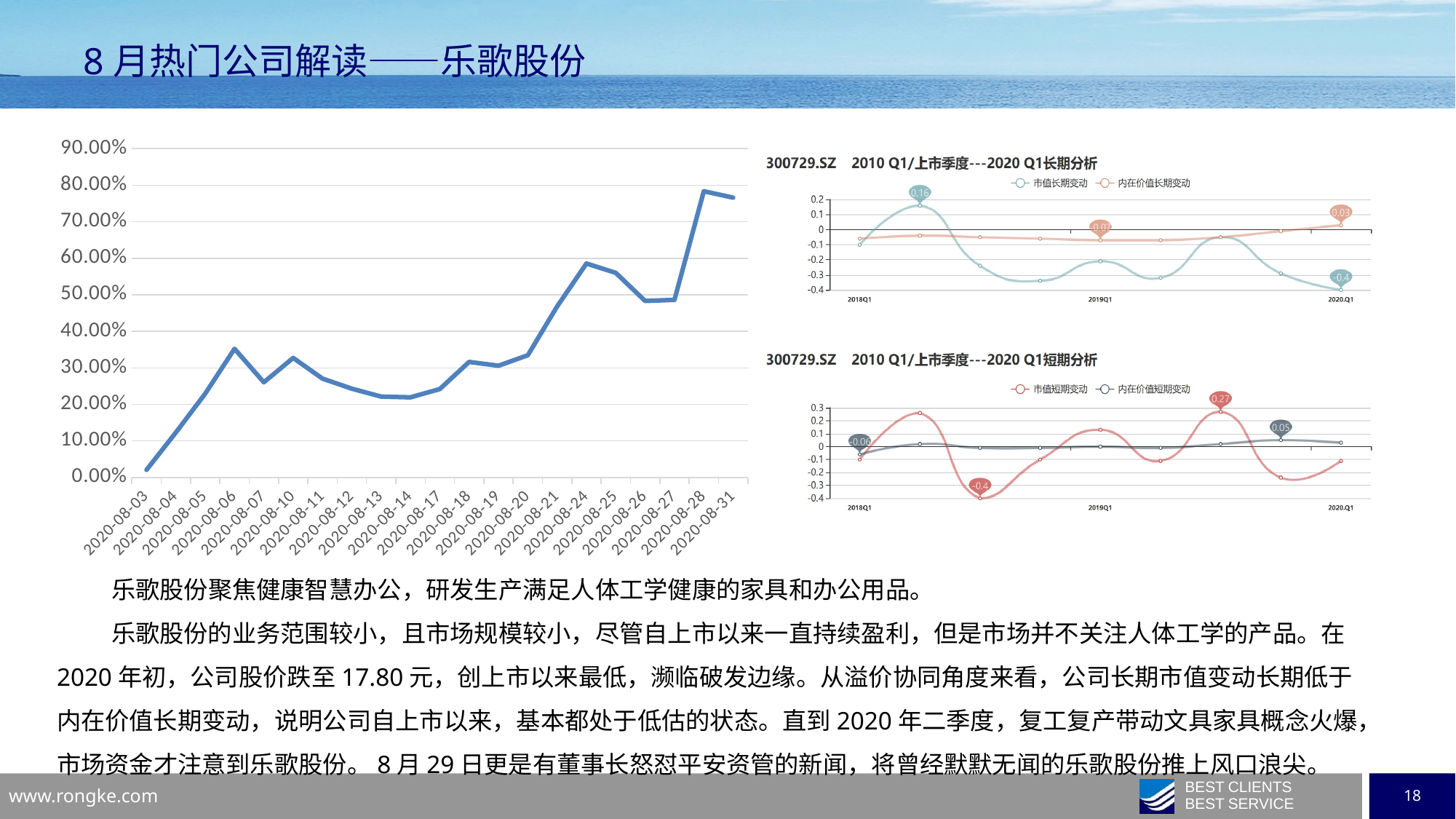
In the large chart on the left, which is larger, the value for 2020-08-06 or the value for 2020-08-14? 2020-08-06 In the large chart on the left, is the value for 2020-08-28 greater or less than 70.00%? greater In the bottom-right chart titled '300729.SZ 2010 Q1/上市季度---2020 Q1短期分析', what is the highest labelled value of the 市值短期变动 series? 0.27 In the top-right chart titled '300729.SZ 2010 Q1/上市季度---2020 Q1长期分析', how many series does the legend list? 2 In the large chart on the left, which date has the lowest value? 2020-08-03 In the large chart on the left, is the value for 2020-08-13 greater or less than 30.00%? less In the large chart on the left, how many dates are shown on the x axis? 21 What kind of chart is the large chart on the left of the slide? line chart In the large chart on the left, which date has the highest value? 2020-08-28 In the top-right chart titled '300729.SZ 2010 Q1/上市季度---2020 Q1长期分析', what is the highest labelled value of the 市值长期变动 series? 0.16 In the large chart on the left, do the values overall rise or fall from 2020-08-03 to 2020-08-31? rise In the large chart on the left, is the value for 2020-08-03 greater or less than 10.00%? less